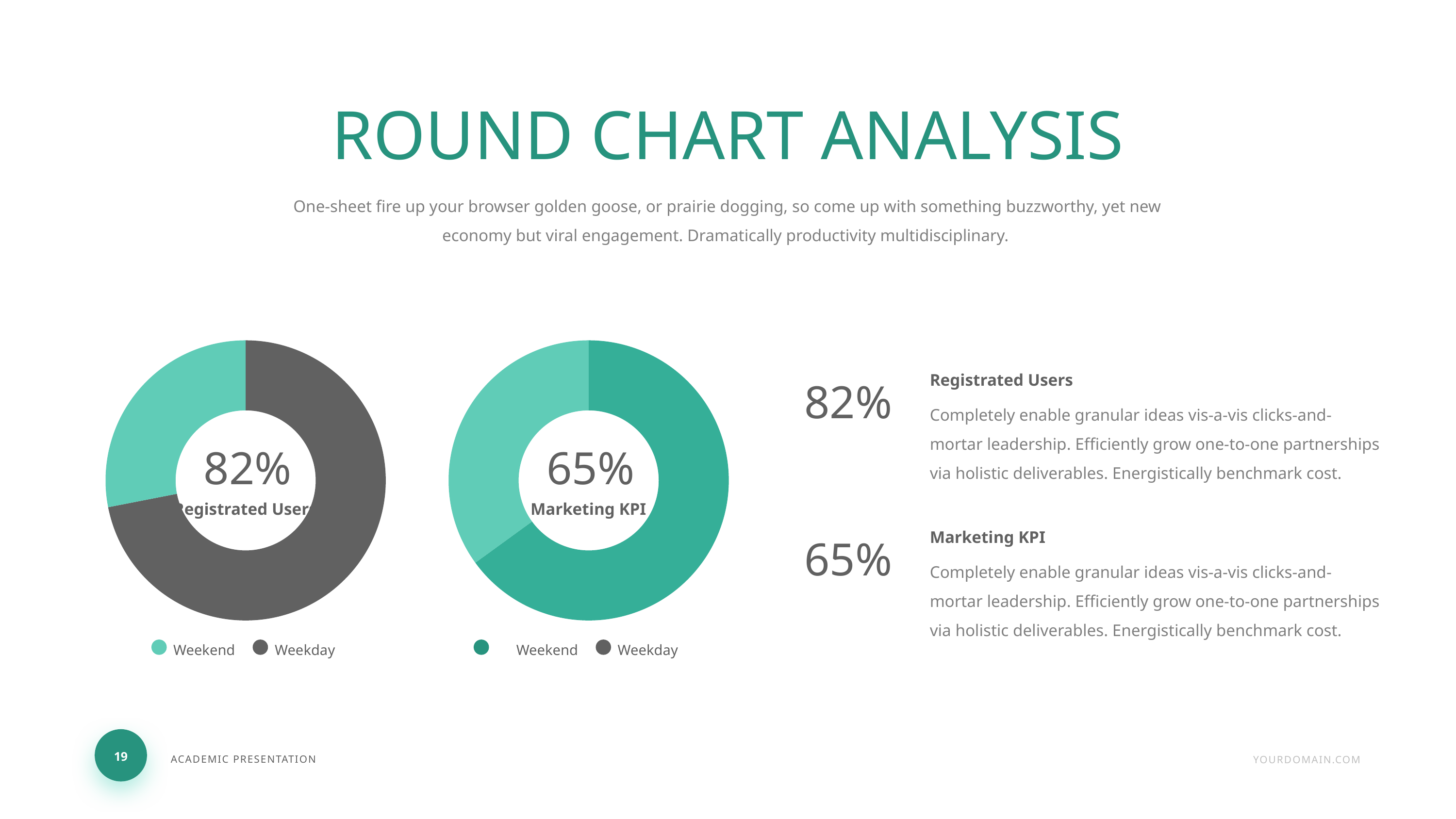
What kind of chart is the right chart labelled Marketing KPI? Doughnut chart In the left chart (Registrated User), what percentage is printed in the centre? 82% In the left chart (Registrated User), what colour represents Weekday? Dark grey In the right chart (Marketing KPI), which slice is larger, Weekend or Weekday? Weekend What are the two legend entries of the right chart (Marketing KPI)? Weekend and Weekday What kind of chart is the left chart labelled Registrated User? Doughnut chart In the left chart (Registrated User), which slice is larger, Weekend or Weekday? Weekday How many slices does the left chart (Registrated User) have? 2 In the right chart (Marketing KPI), which category has the largest slice? Weekend How many entries does the legend of the right chart (Marketing KPI) list? 2 In the left chart (Registrated User), which category has the smallest slice? Weekend In the right chart (Marketing KPI), what percentage is printed in the centre? 65%